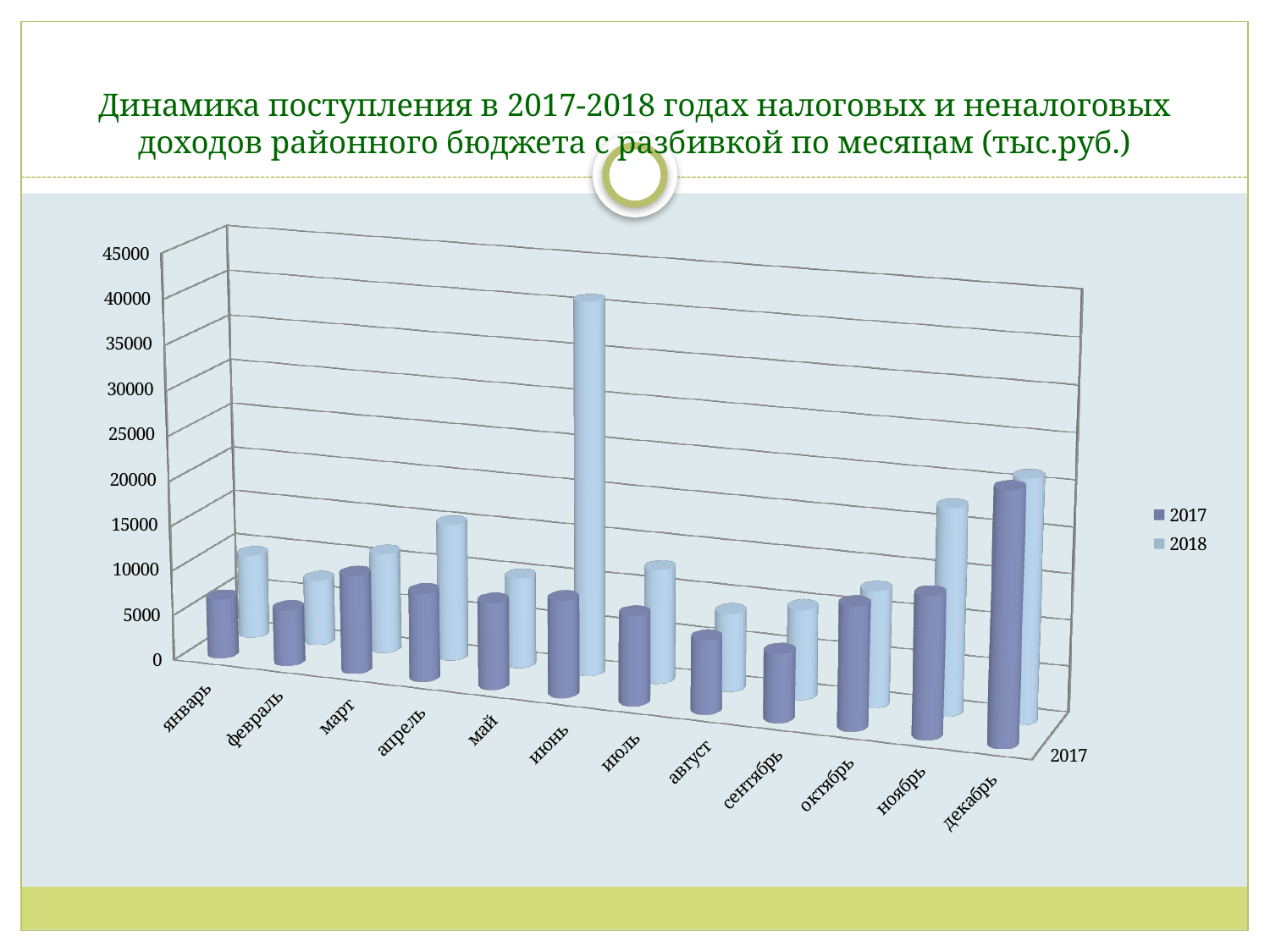
What kind of chart is shown on the slide? bar chart In which month is the 2017 value highest? декабрь Is the 2018 value for июнь greater or less than 25000? greater Which series are listed in the legend? 2017 and 2018 Is the 2017 value for декабрь greater or less than 10000? greater For the 2017 series, which month has the larger value, январь or декабрь? декабрь For июнь, which series has the larger value, 2017 or 2018? 2018 How many series does the legend list? 2 In which month is the 2018 value highest? июнь Do the 2017 values rise or fall from октябрь to декабрь? rise How many months are shown on the x axis of the chart? 12